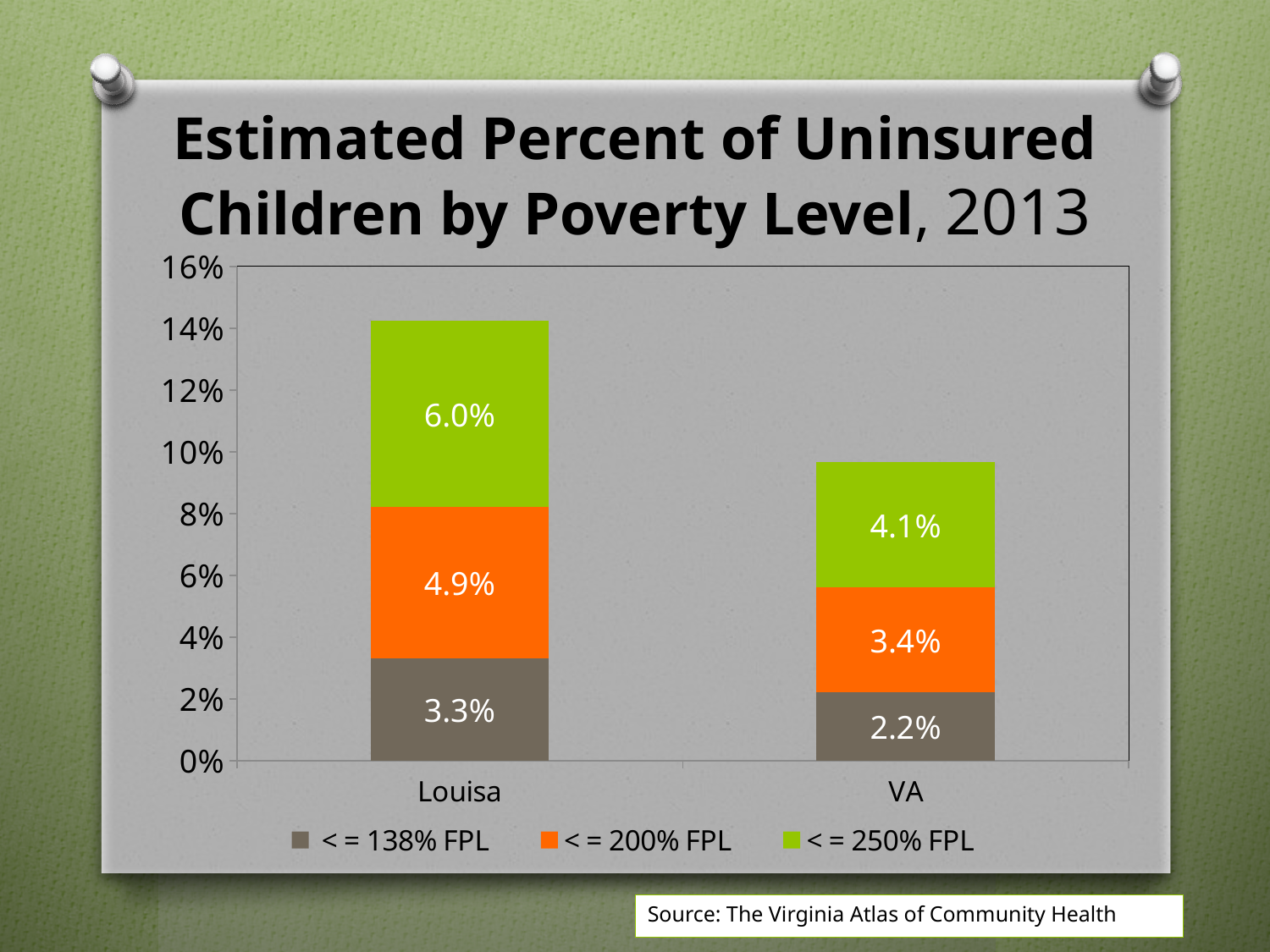
What is the total of the stacked bar for Louisa? 14.2% Which colour represents the < = 200% FPL series in the legend? Orange Which category has the taller stacked bar overall? Louisa What is the difference between the < = 200% FPL values for Louisa and VA? 1.5% What is the value for VA in the < = 250% FPL series? 4.1% What kind of chart is shown on the slide? Stacked bar chart What is the value for VA in the < = 200% FPL series? 3.4% What is the value for Louisa in the < = 138% FPL series? 3.3% How many series does the legend list? 3 What is the total of the stacked bar for VA? 9.7% How many categories are shown on the x axis? 2 Which category has the higher value in the < = 250% FPL series, Louisa or VA? Louisa